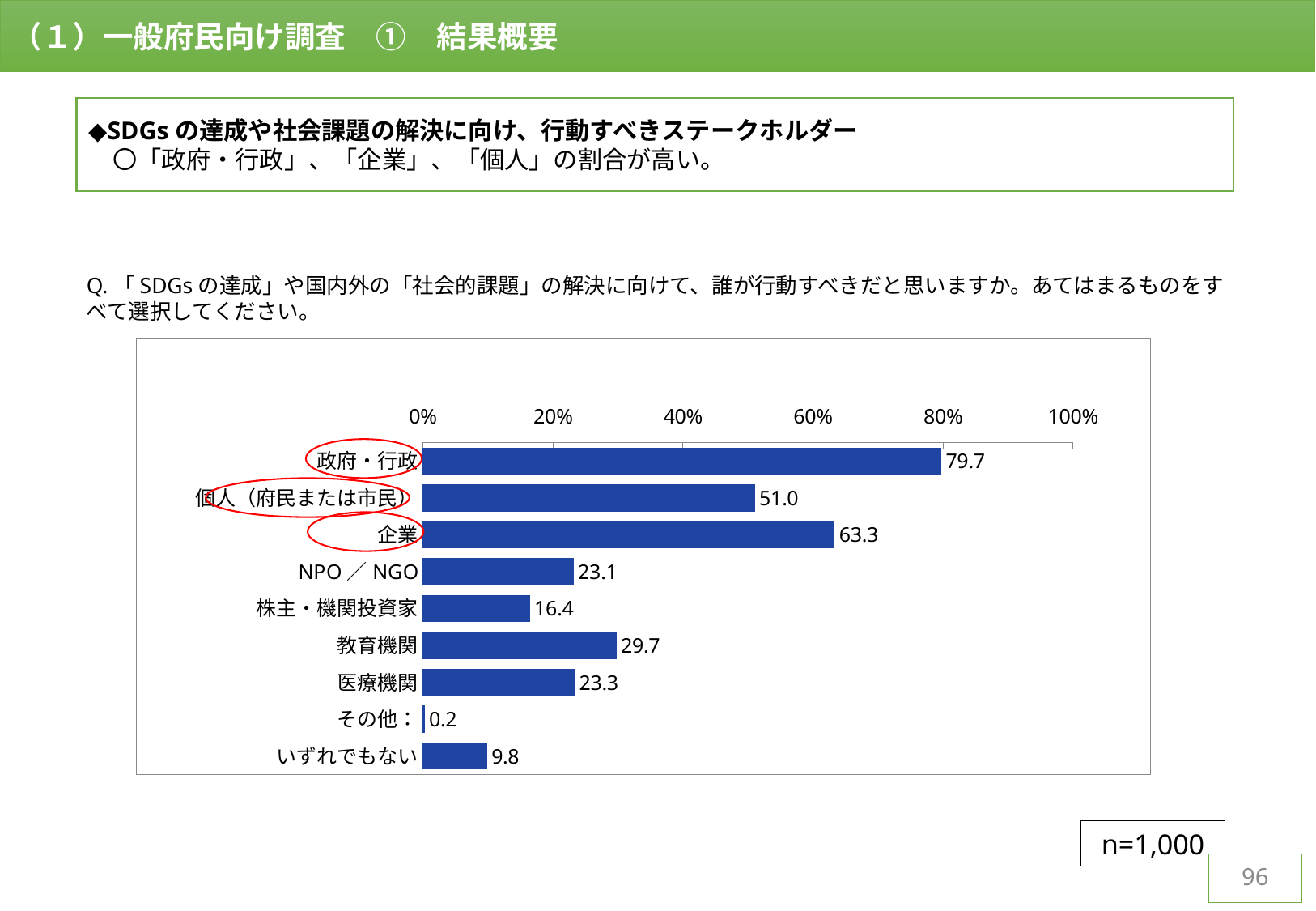
What is the value for 企業? 63.3 How many categories are shown in the chart? 9 Which category has the highest value? 政府・行政 What is the sample size shown next to the chart? n=1,000 What kind of chart is shown on the slide? bar chart What is the value for 政府・行政? 79.7 What is the difference between the values for 政府・行政 and 企業? 16.4 What is the value for その他：? 0.2 What is the value for 教育機関? 29.7 Which category has the lowest value? その他： Is the value for 個人（府民または市民） greater or less than 40%? greater Which is larger, the value for NPO／NGO or the value for 医療機関? 医療機関